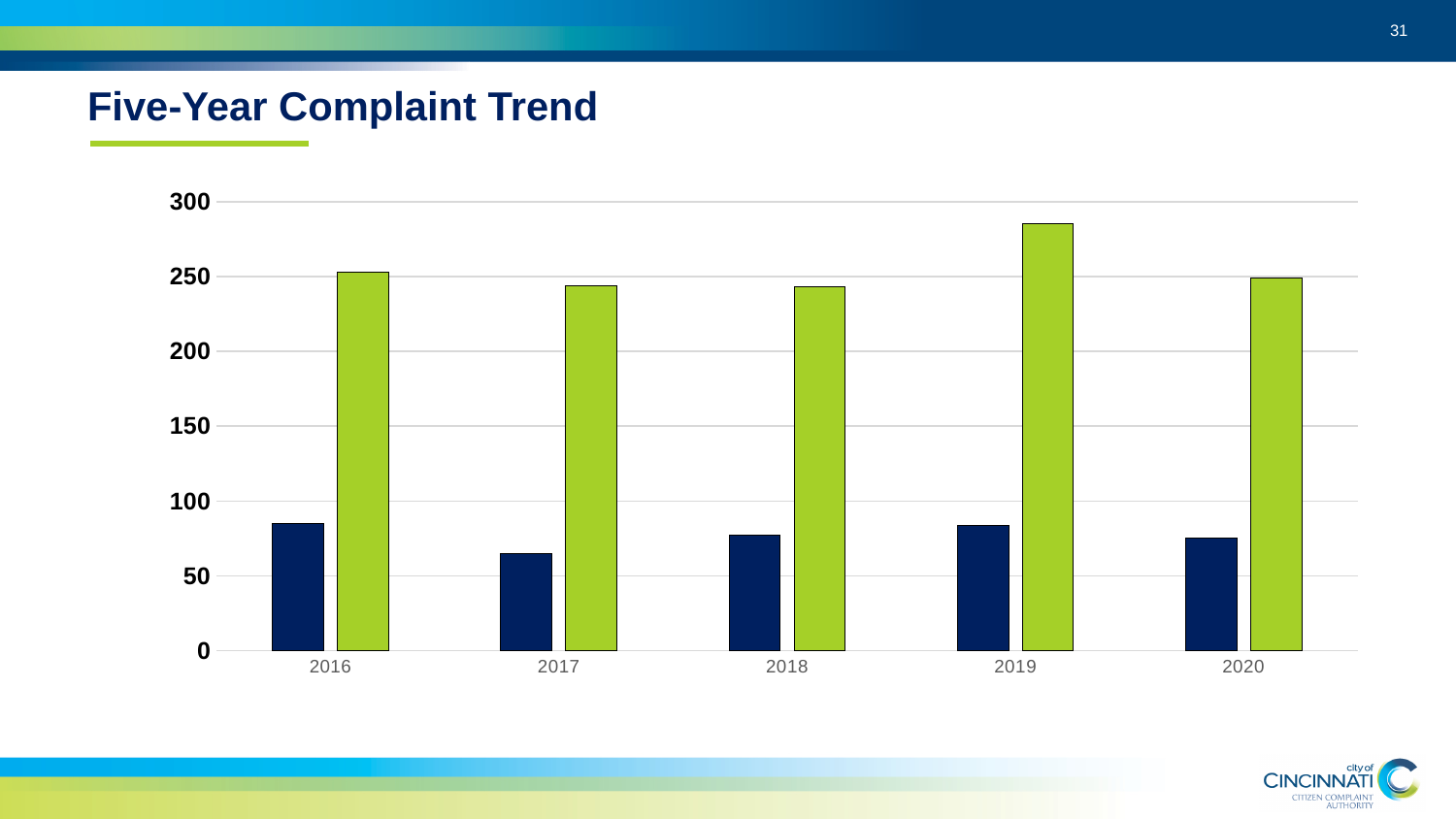
Is the dark blue bar for 2017 greater or less than 50? greater How many years are shown on the x axis of the chart? 5 Is the dark blue bar for 2016 greater or less than 100? less What is the title of the chart? Five-Year Complaint Trend Which year has the shortest dark blue bar? 2017 Which is larger in 2018, the dark blue bar or the green bar? the green bar Is the green bar for 2017 greater or less than 200? greater Which year has a larger green bar, 2019 or 2020? 2019 What is the highest value shown on the y axis of the chart? 300 Which year has the tallest green bar? 2019 What kind of chart is shown on the slide? bar chart